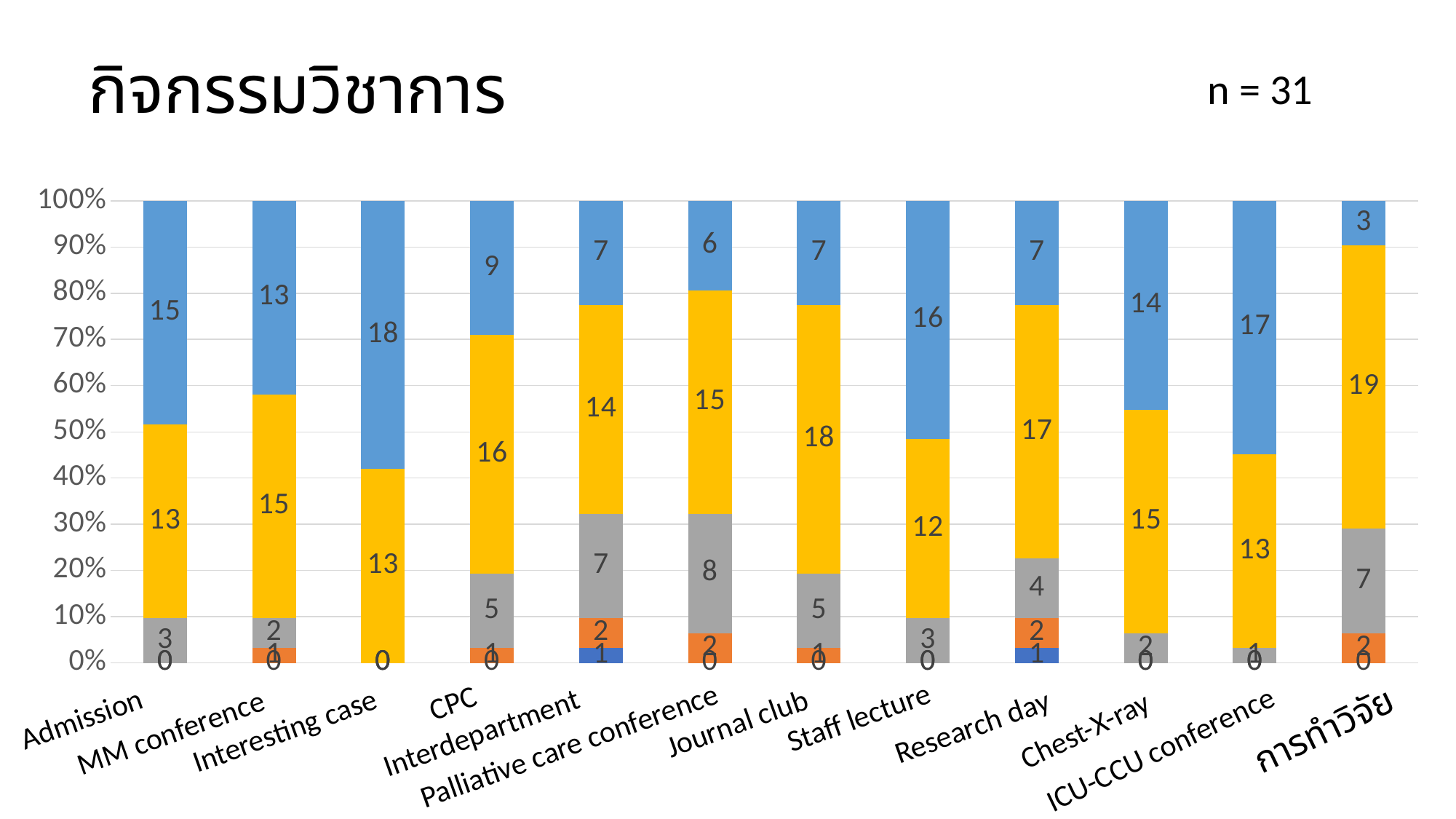
What is the value of the yellow segment for Journal club? 18 Which is larger: the yellow segment for CPC or the yellow segment for Admission? CPC What sample size (n) is stated on the slide? n = 31 Which category has the largest yellow segment? การทำวิจัย Which category has the smallest light blue (top) segment? การทำวิจัย What is the difference between the light blue (top) segment values for Staff lecture and Research day? 9 What is the value of the yellow segment for การทำวิจัย? 19 What kind of chart is shown on the slide? 100% stacked bar chart What is the title of the chart slide? กิจกรรมวิชาการ What is the value of the light blue (top) segment for Interesting case? 18 How many categories are shown along the x axis of the chart? 12 What is the value of the gray segment for Palliative care conference? 8